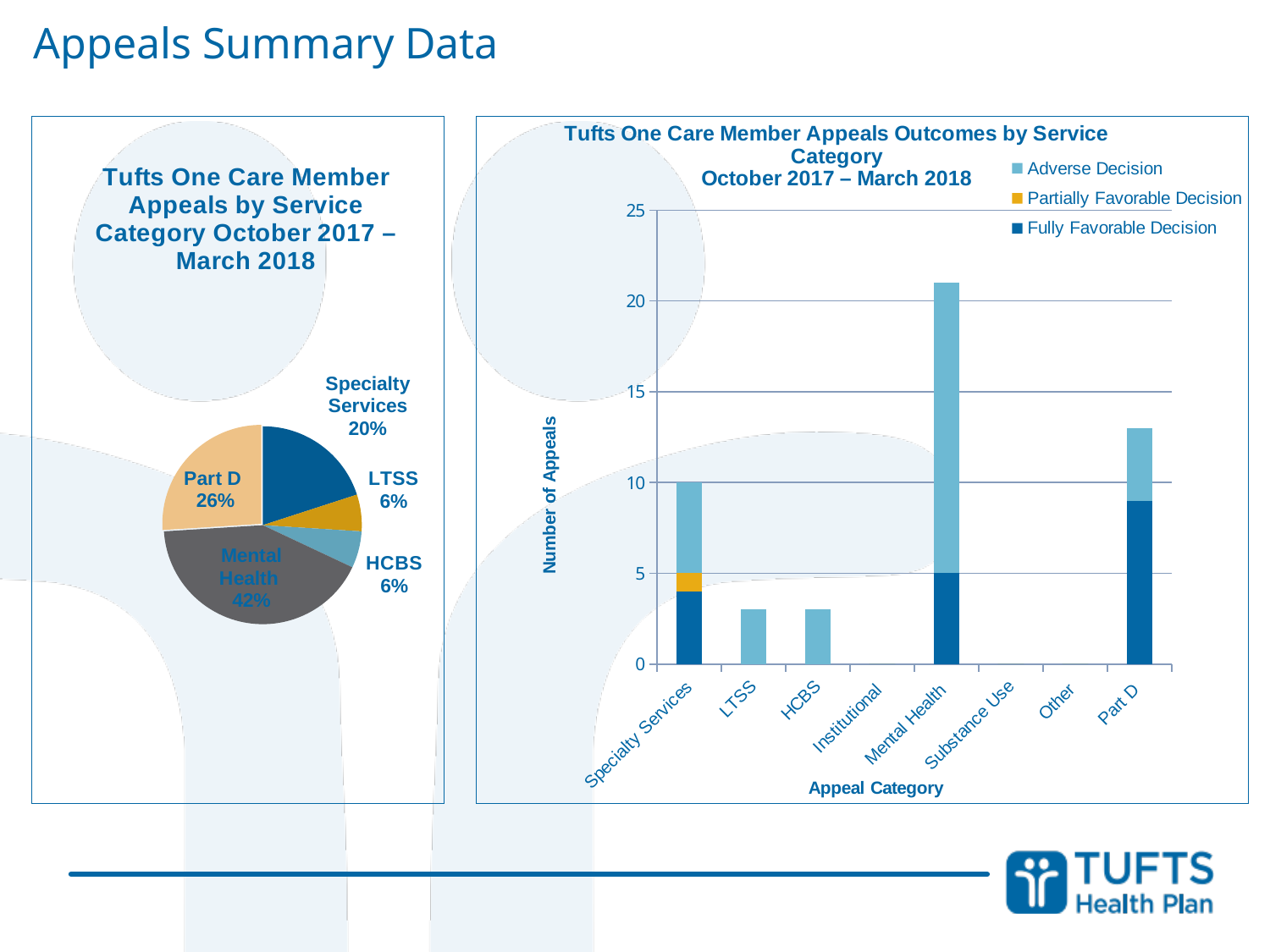
In the bar chart on the right, which appeal category has the tallest bar? Mental Health How many series does the legend of the bar chart on the right list? 3 In the bar chart on the right, is the total number of appeals for LTSS greater or less than 5? less How many appeal categories are shown on the x axis of the bar chart on the right? 8 How many slices does the pie chart on the left have? 5 In the pie chart on the left, which service category has the largest share of appeals? Mental Health In the pie chart on the left, which is larger, the Part D share or the Specialty Services share? Part D What kind of chart is the chart on the right, titled 'Tufts One Care Member Appeals Outcomes by Service Category'? Stacked bar chart In the pie chart on the left, what is the difference in percentage points between Mental Health and Specialty Services? 22 In the pie chart on the left, what share of appeals is Mental Health? 42% In the bar chart on the right, is the total number of appeals for Mental Health greater or less than 20? greater In the pie chart on the left, what share of appeals is Part D? 26%